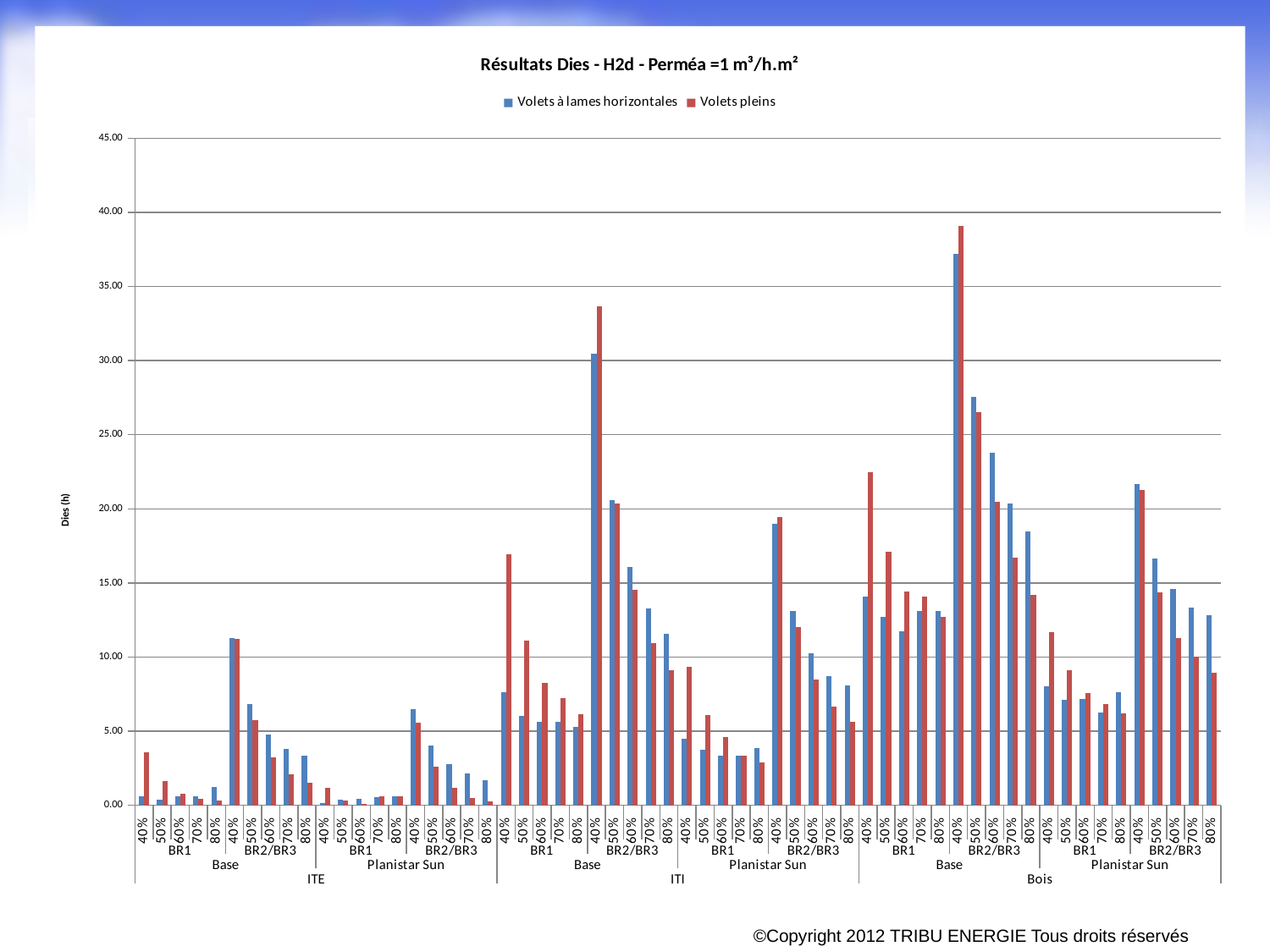
For Bois / Base / BR2/BR3 / 70%, which series has the larger value, Volets à lames horizontales or Volets pleins? Volets à lames horizontales Is the Volets à lames horizontales value for ITE / Base / BR2/BR3 / 40% greater or less than 10.00? greater Within ITE / Base / BR2/BR3, do the Volets pleins values rise or fall from 40% to 80%? fall What kind of chart is shown on the slide? bar chart How many top-level wall-type groups (ITE, ITI, Bois) are shown on the x axis? 3 How many series does the legend list? 2 In which top-level group (ITE, ITI or Bois) does the tallest bar of the chart appear? Bois Is the Volets pleins value for Bois / Base / BR2/BR3 / 40% greater or less than 35.00? greater What is the label on the vertical axis? Dies (h) Is the Volets pleins value for ITI / Base / BR2/BR3 / 40% greater or less than 30.00? greater For Bois / Base / BR1 / 40%, which series has the larger value, Volets à lames horizontales or Volets pleins? Volets pleins What is the title of the chart? Résultats Dies - H2d - Perméa =1 m³/h.m²